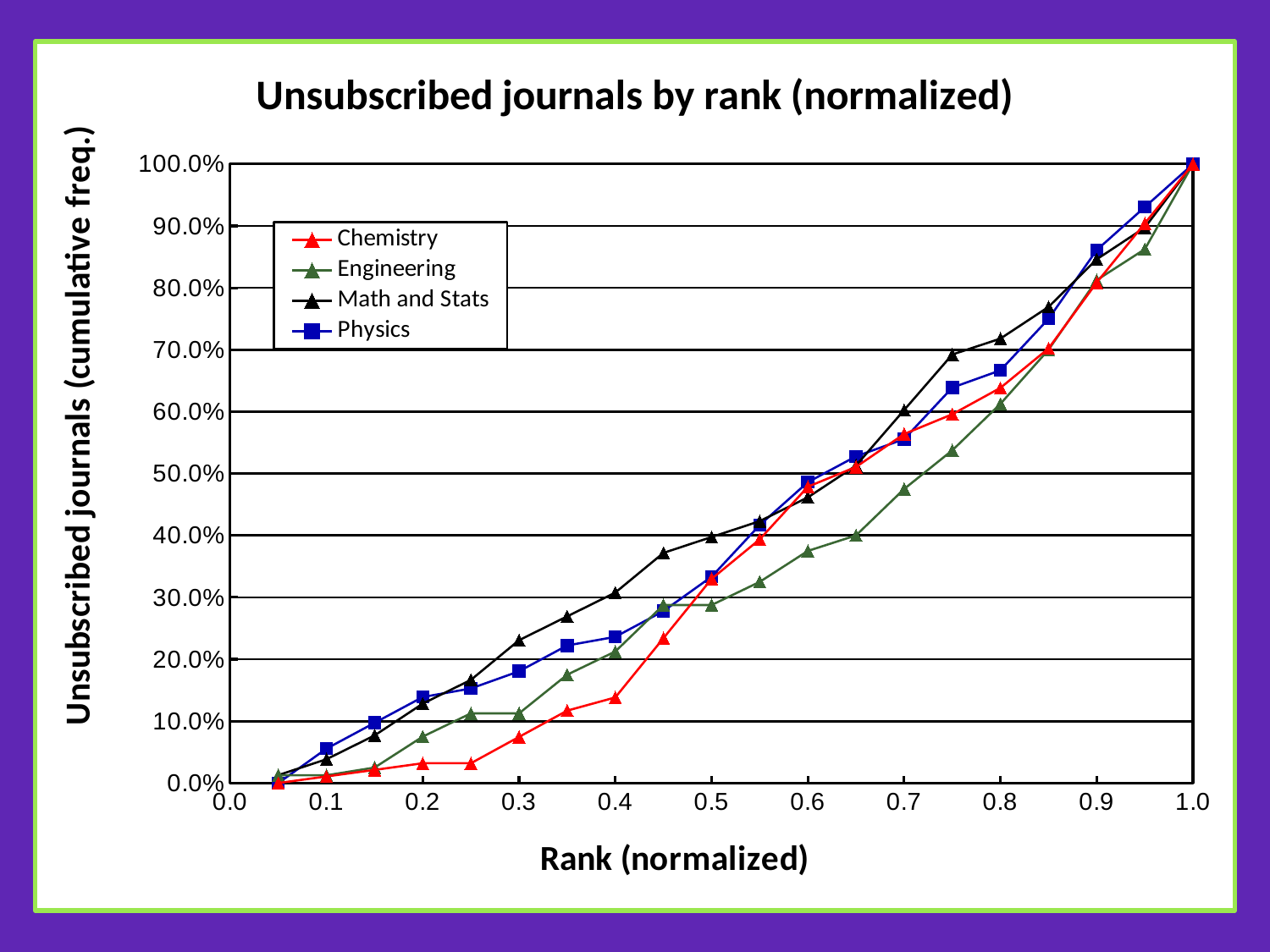
Which series has the lowest value at rank 0.4? Chemistry Is the value for Physics at rank 0.9 greater or less than 80.0%? greater What is the title of the chart? Unsubscribed journals by rank (normalized) How many series does the legend list? 4 Is the value for Chemistry at rank 0.4 greater or less than 20.0%? less Do the values for Math and Stats rise or fall as rank increases along the x axis? Rise At rank 0.75, which is larger: the value for Engineering or the value for Math and Stats? Math and Stats At rank 0.4, which is larger: the value for Math and Stats or the value for Chemistry? Math and Stats Is the value for Math and Stats at rank 0.45 greater or less than 30.0%? greater What kind of chart is shown on the slide? Line chart What is the label of the x axis? Rank (normalized) What value does the Chemistry series reach at rank 1.0? 100.0%